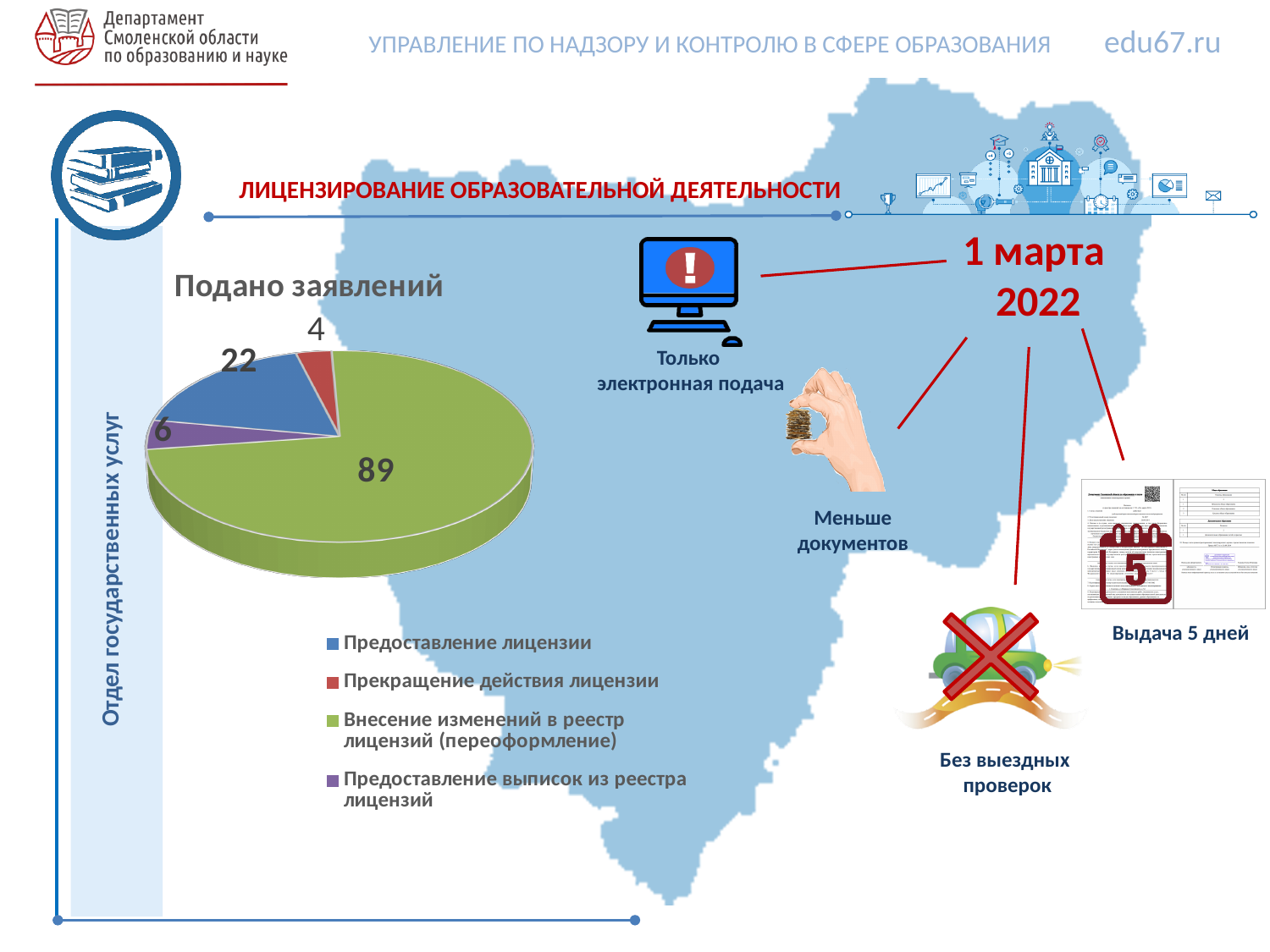
What is the difference between the values for "Внесение изменений в реестр лицензий (переоформление)" and "Предоставление лицензии" in the pie chart? 67 What is the title of the pie chart on the slide? Подано заявлений How many categories does the pie chart contain? 4 Which category has the smallest slice in the pie chart? Прекращение действия лицензии What colour is the slice for "Предоставление выписок из реестра лицензий" in the pie chart? purple Which is larger in the pie chart: "Предоставление лицензии" or "Предоставление выписок из реестра лицензий"? Предоставление лицензии What value does the pie chart show for "Прекращение действия лицензии"? 4 Which category has the largest slice in the pie chart? Внесение изменений в реестр лицензий (переоформление) What value does the pie chart show for "Предоставление выписок из реестра лицензий"? 6 What value does the pie chart show for "Внесение изменений в реестр лицензий (переоформление)"? 89 How many applications are shown for "Предоставление лицензии" in the pie chart? 22 What kind of chart is shown under the heading "Подано заявлений"? pie chart